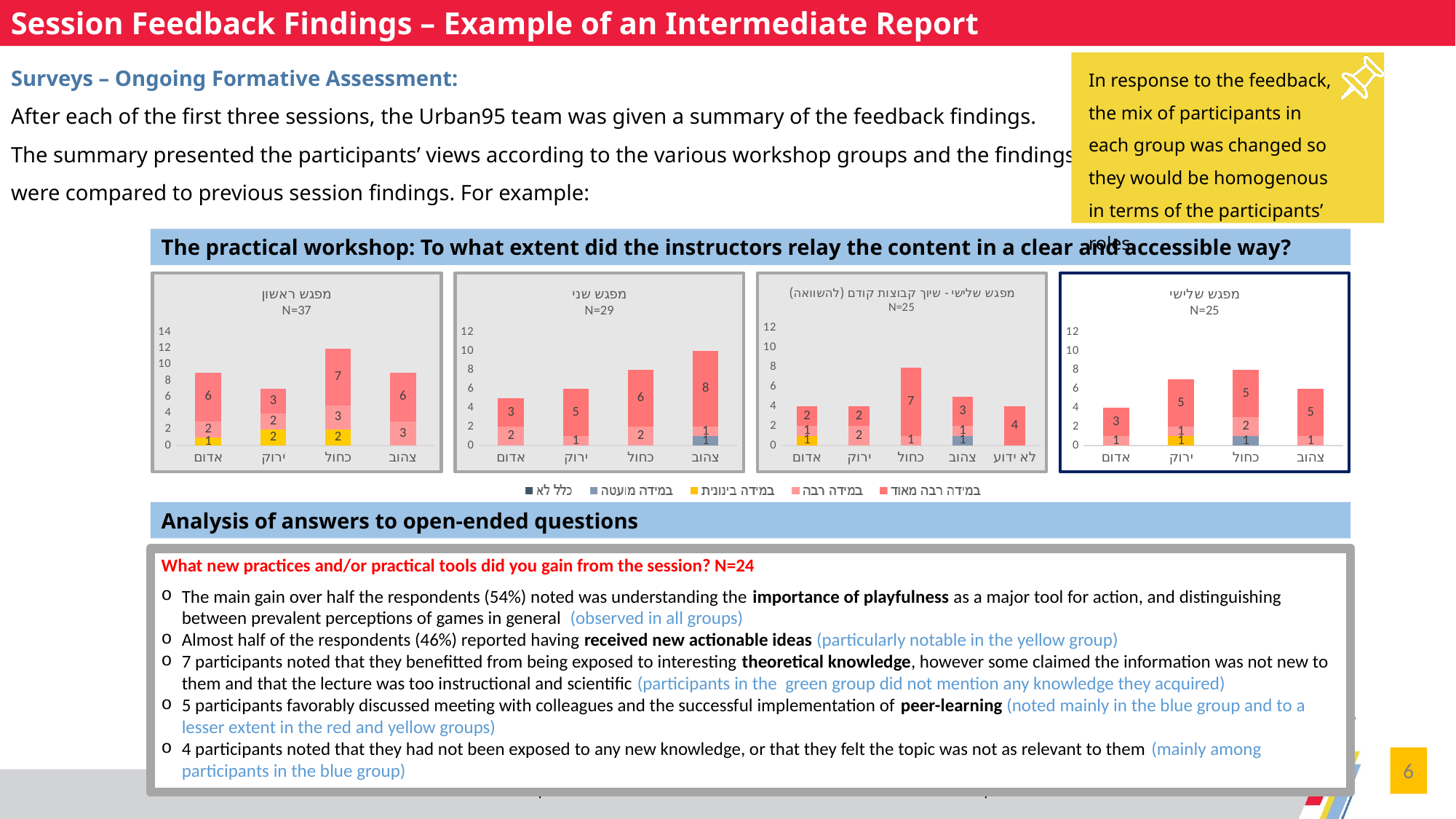
In the rightmost chart (מפגש שלישי, N=25), what is the total of the stacked bar for the ירוק category? 7 In the rightmost chart (מפגש שלישי, N=25), what is the difference between the top-segment values for ירוק (5) and אדום (3)? 2 In the leftmost chart (מפגש ראשון, N=37), what is the value of the top (במידה רבה מאוד) segment for the כחול category? 7 In the leftmost chart (מפגש ראשון, N=37), which category has the tallest stacked bar? כחול How many charts are shown in the row under the heading 'The practical workshop: To what extent did the instructors relay the content in a clear and accessible way?' 4 In the second chart from the left (מפגש שני, N=29), which category has the shortest stacked bar? אדום In the second chart from the left (מפגש שני, N=29), what is the total of the stacked bar for the אדום category? 5 What type of chart is the leftmost chart (מפגש ראשון, N=37)? stacked bar chart How many series does the shared legend below the four charts list? 5 In the third chart from the left (מפגש שלישי - שיוך קבוצות קודם, N=25), what is the value of the top segment for the כחול category? 7 In the second chart from the left (מפגש שני, N=29), what is the value of the top (במידה רבה מאוד) segment for the צהוב category? 8 In the leftmost chart (מפגש ראשון, N=37), what is the total of the stacked bar for the כחול category? 12